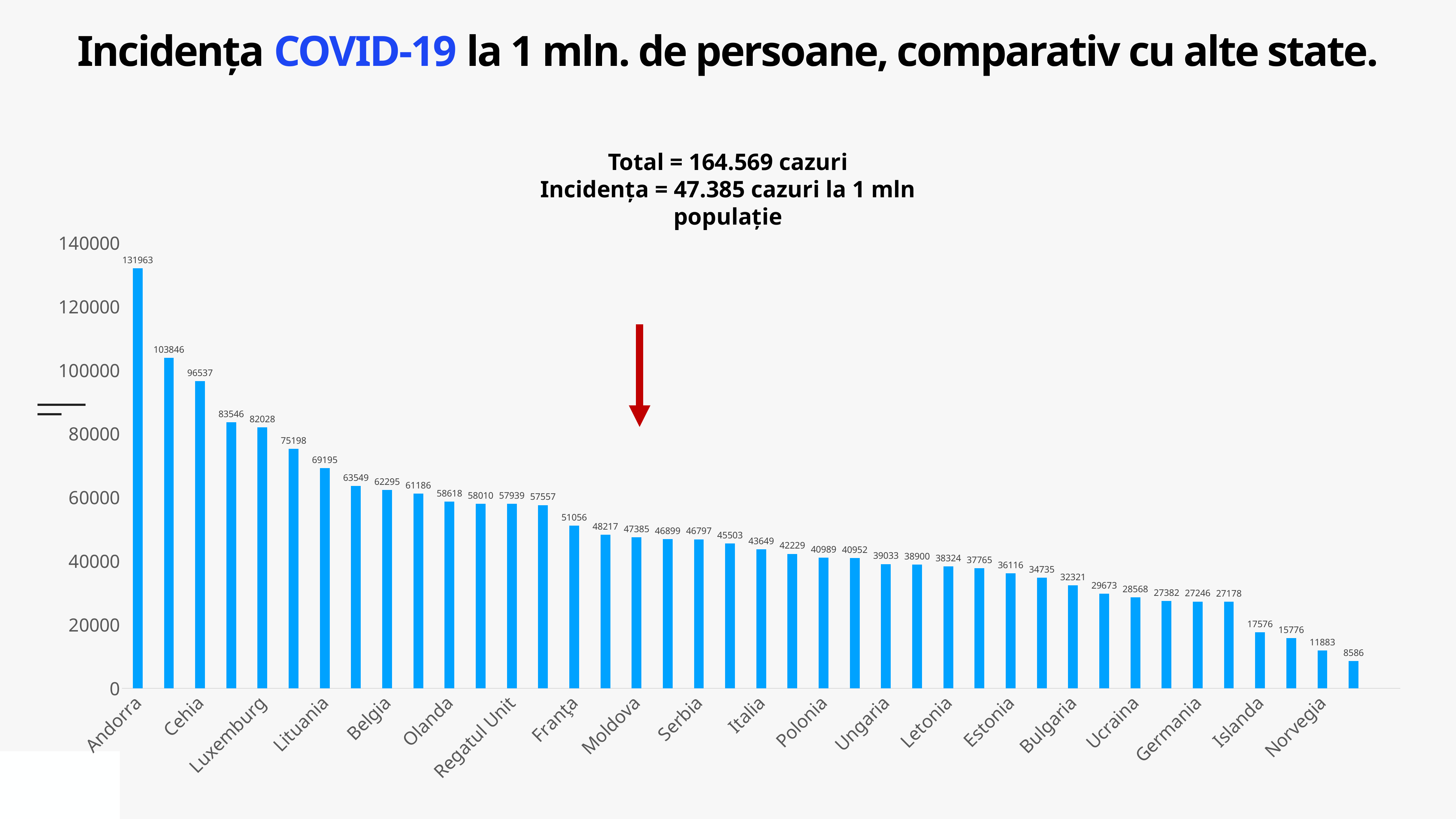
What kind of chart is shown on the slide? bar chart What is the incidence value shown for Andorra? 131963 What is the incidence value shown for Germania? 27246 Do the values rise or fall from left to right along the x axis? fall What is the incidence value shown for Moldova? 47385 How many bars are plotted in the chart? 40 Which has a higher value, Cehia or Luxemburg? Cehia What is the difference between the values for Andorra and Moldova? 84578 Is the value for Norvegia greater or less than 20000? less What is the difference between the values for Moldova and Serbia? 588 Which country has the highest incidence in the chart? Andorra What is the incidence value shown for Franța? 51056